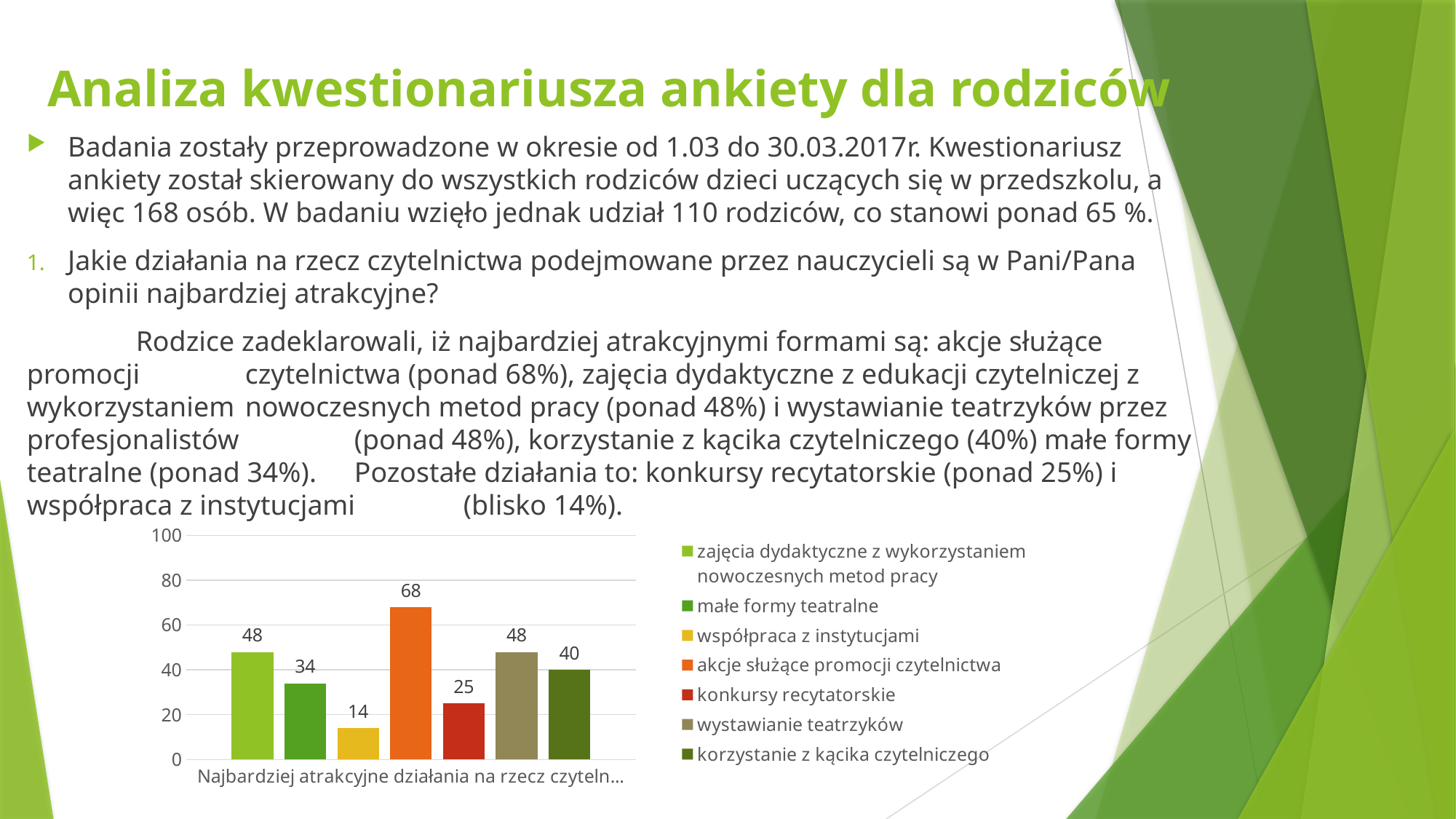
What is the value for "współpraca z instytucjami"? 14 What colour is the bar for "akcje służące promocji czytelnictwa"? orange What is the value for "małe formy teatralne"? 34 What is the value for "korzystanie z kącika czytelniczego"? 40 What is the value for "konkursy recytatorskie"? 25 Which is larger: the value for "małe formy teatralne" or the value for "konkursy recytatorskie"? małe formy teatralne Which series has the highest value? akcje służące promocji czytelnictwa Which series has the lowest value? współpraca z instytucjami What type of chart is shown on the slide? bar chart How many series does the chart legend list? 7 What is the value for "akcje służące promocji czytelnictwa"? 68 What is the difference between the values for "akcje służące promocji czytelnictwa" and "korzystanie z kącika czytelniczego"? 28